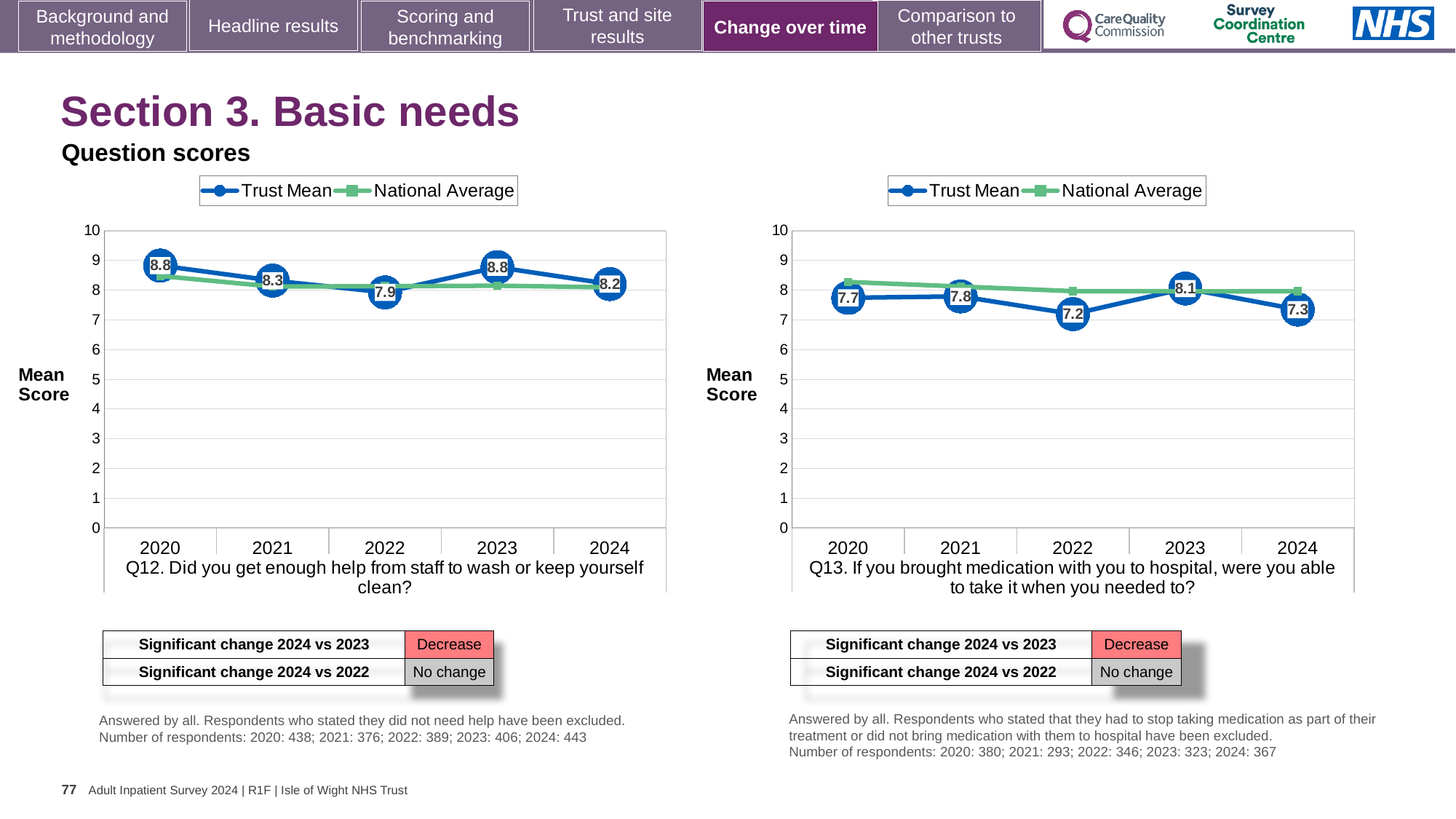
In the left chart (Q12), what is the Trust Mean score for 2022? 7.9 In the left chart (Q12), which year has the lowest Trust Mean score? 2022 In the right chart (Q13), which year has the highest Trust Mean score? 2023 In the right chart (Q13), is the National Average for 2020 greater or less than 8? greater In the right chart (Q13), what is the difference between the Trust Mean scores for 2023 and 2024? 0.8 How many series does the legend of the right chart (Q13) list? 2 What type of chart is used for Q13 on the right? Line chart In the left chart (Q12), is the Trust Mean score for 2021 or 2023 higher? 2023 How many years are plotted on the x axis of the left chart (Q12)? 5 In the right chart (Q13), what is the Trust Mean score for 2024? 7.3 In the left chart (Q12), what is the Trust Mean score for 2020? 8.8 In the right chart (Q13), what is the Trust Mean score for 2023? 8.1